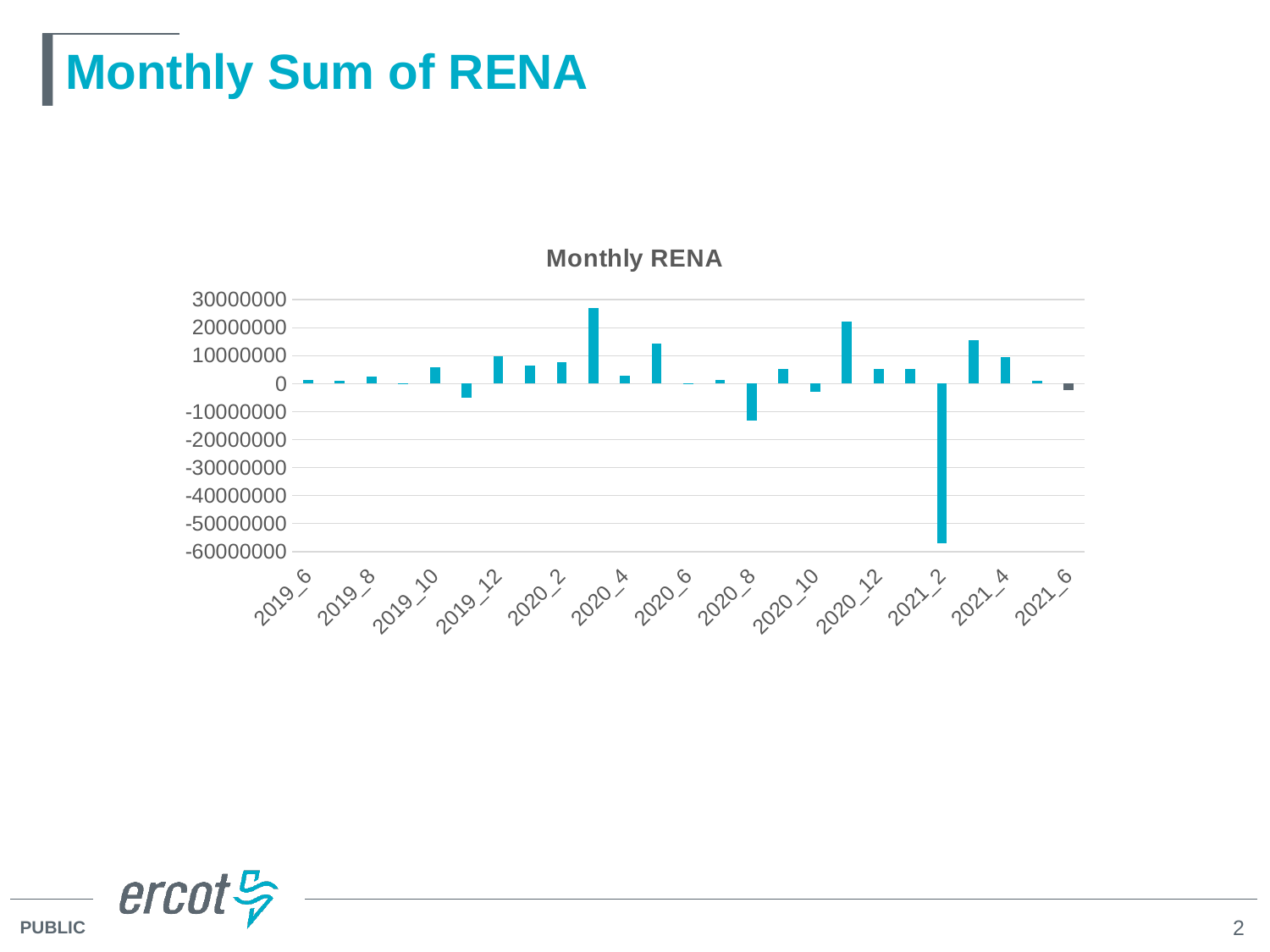
What kind of chart is shown on the slide? bar chart Is the value for 2021_6 greater or less than 0? less Is the value for 2020_4 greater or less than 10000000? less Which is larger, the value for 2019_12 or the value for 2019_6? 2019_12 What is the title of the chart? Monthly RENA Is the value for 2020_8 greater or less than -10000000? less How many month labels are shown on the x axis? 13 Which is larger, the value for 2020_12 or the value for 2021_4? 2021_4 Which month has the lowest value in the Monthly RENA chart? 2021_2